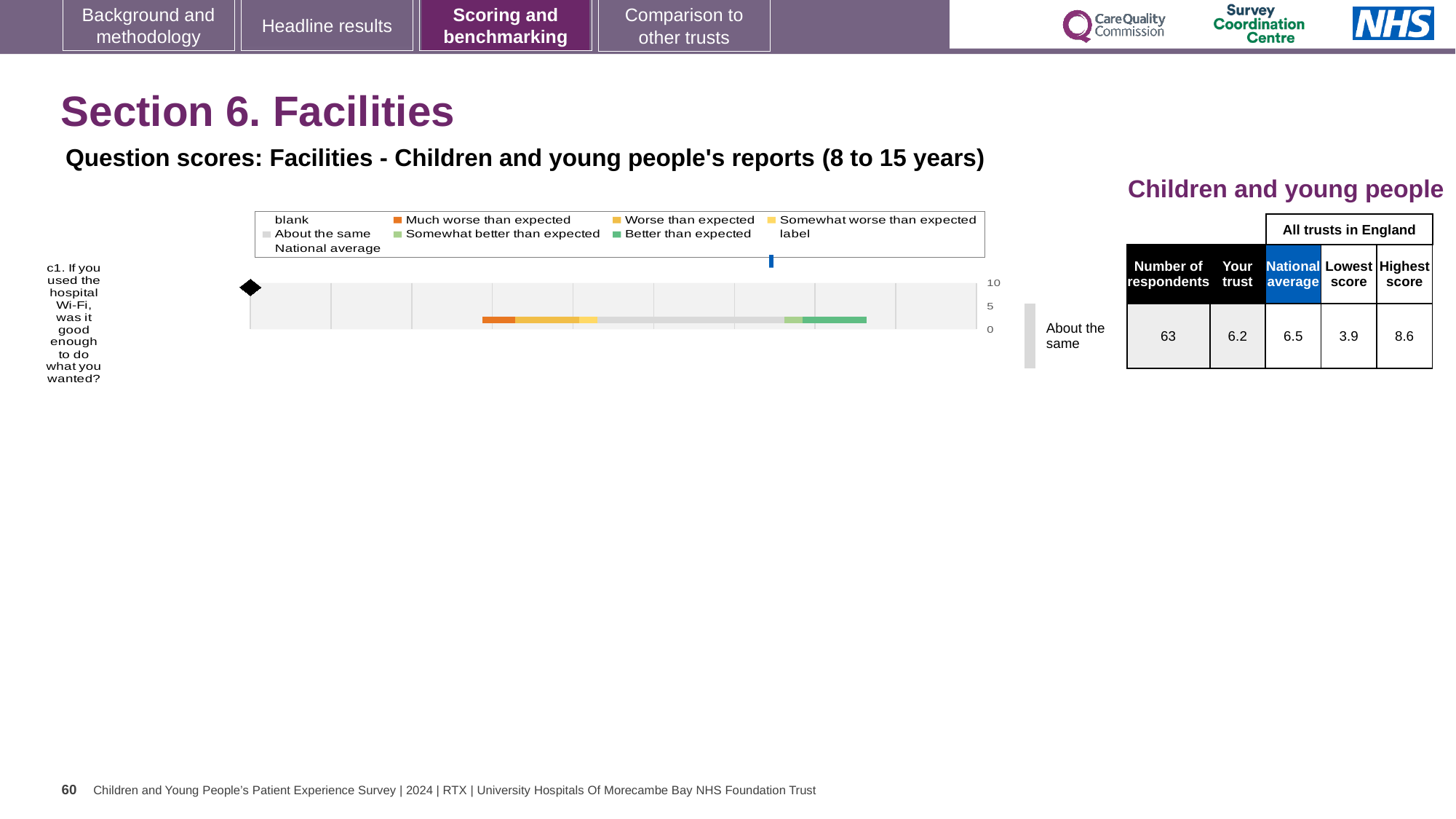
Which is larger for question c1: the 'Your trust' score or the national average? National average What benchmark category is shown for the trust's result on question c1? About the same What is the national average score for question c1 (hospital Wi-Fi)? 6.5 By how much does the national average exceed the 'Your trust' score for question c1? 0.3 What kind of chart is used to show the question score for c1 on this slide? bar chart What is the 'Your trust' score for question c1 (hospital Wi-Fi)? 6.2 What is the lowest score among all trusts in England for question c1? 3.9 How many respondents answered question c1 (hospital Wi-Fi)? 63 What is the difference between the highest and lowest scores for question c1? 4.7 What is the highest score among all trusts in England for question c1? 8.6 How many survey questions are plotted in the chart on this slide? 1 How many entries does the chart legend list? 9